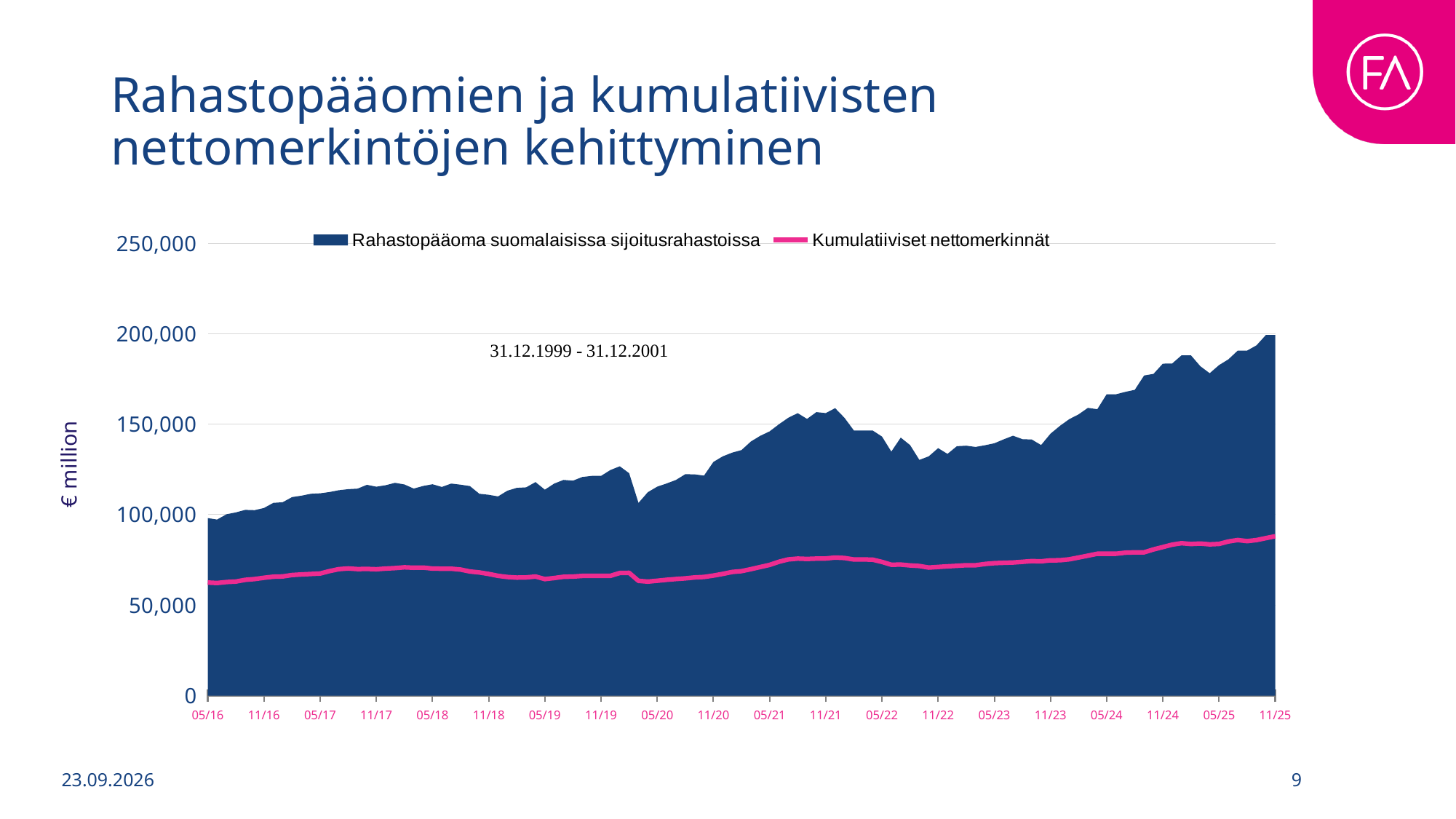
What are the two series named in the legend? Rahastopääoma suomalaisissa sijoitusrahastoissa; Kumulatiiviset nettomerkinnät What kind of chart is shown on the slide? area chart with a line series At which x-axis label does Rahastopääoma suomalaisissa sijoitusrahastoissa reach its highest value? 11/25 Is the value of Rahastopääoma suomalaisissa sijoitusrahastoissa at 05/20 greater or less than 100,000? greater Is the value of Kumulatiiviset nettomerkinnät at 11/25 greater or less than 100,000? less How many series does the legend list? 2 At which x-axis label is Rahastopääoma suomalaisissa sijoitusrahastoissa at its lowest value? 05/16 What is the label on the vertical axis? € million Does Rahastopääoma suomalaisissa sijoitusrahastoissa overall rise or fall from 05/16 to 11/25? rise At 11/25, which series has the larger value: Rahastopääoma suomalaisissa sijoitusrahastoissa or Kumulatiiviset nettomerkinnät? Rahastopääoma suomalaisissa sijoitusrahastoissa Is the value of Rahastopääoma suomalaisissa sijoitusrahastoissa at 11/21 greater or less than 150,000? greater